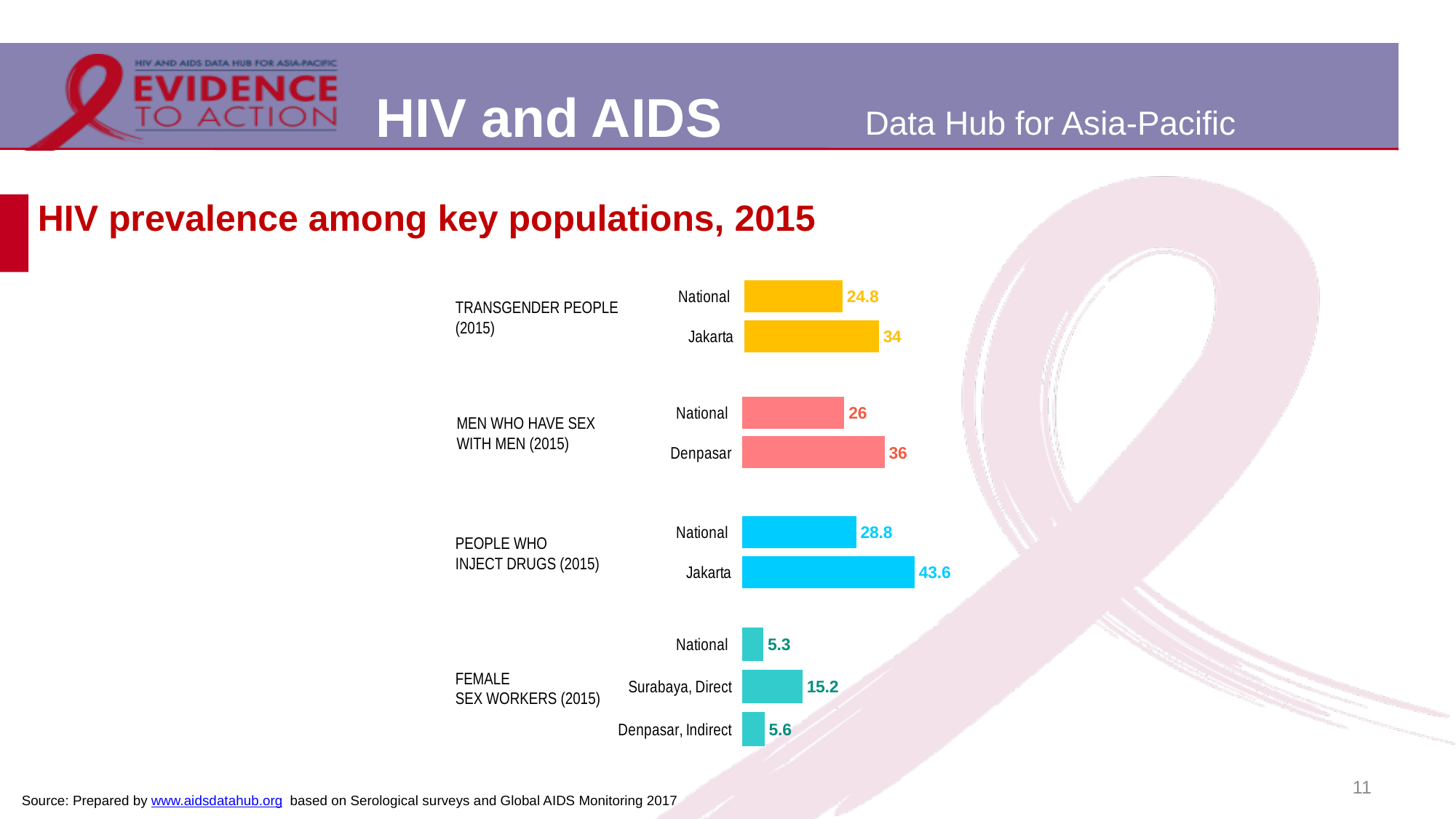
What is the HIV prevalence value for female sex workers in Surabaya, Direct? 15.2 What is the HIV prevalence value for transgender people in Jakarta? 34 Which bar has the lowest value on the chart? Female sex workers, National What is the HIV prevalence value for people who inject drugs in Jakarta? 43.6 Which bar has the highest value on the chart? People who inject drugs, Jakarta What is the title of the chart on the slide? HIV prevalence among key populations, 2015 What is the national HIV prevalence value for men who have sex with men? 26 What is the difference between the Denpasar and National values for men who have sex with men? 10 How many bars are plotted on the chart? 9 What is the difference between the Jakarta and National values for people who inject drugs? 14.8 Which is larger: the national value for transgender people or the national value for men who have sex with men? Men who have sex with men What kind of chart is shown on the slide? Bar chart